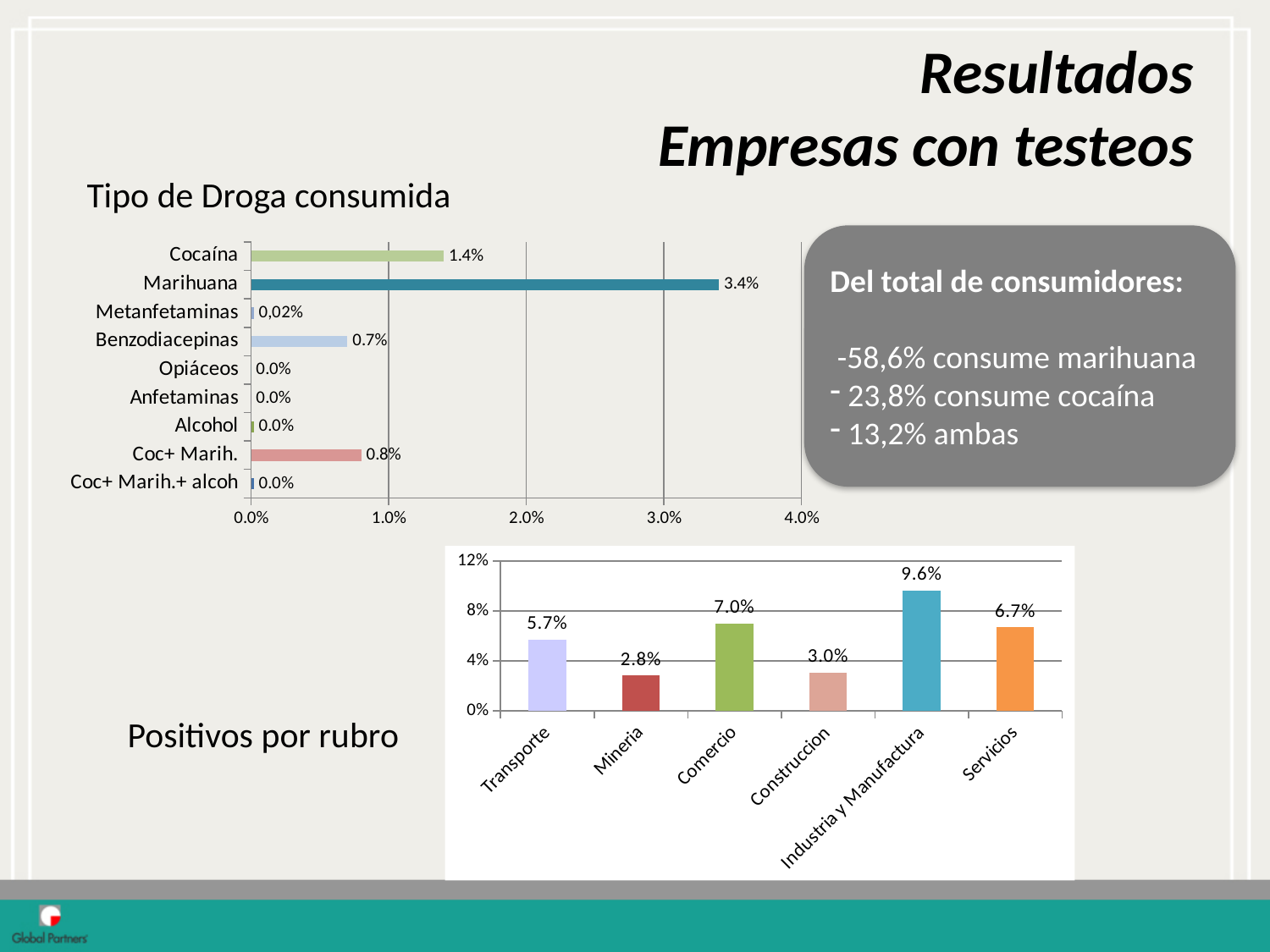
In the 'Tipo de Droga consumida' chart, how many drug categories are listed? 9 In the 'Tipo de Droga consumida' chart, what is the value for Marihuana? 3.4% What type of chart is 'Positivos por rubro'? Bar chart In the 'Positivos por rubro' chart, how many sectors are shown? 6 In the 'Positivos por rubro' chart, what is the difference between Industria y Manufactura and Transporte? 3.9% In the 'Tipo de Droga consumida' chart, what is the value for Coc+ Marih.? 0.8% In the 'Tipo de Droga consumida' chart, what is the value for Cocaína? 1.4% In the 'Positivos por rubro' chart, what is the value for Industria y Manufactura? 9.6% In the 'Positivos por rubro' chart, which sector has the lowest value? Mineria In the 'Tipo de Droga consumida' chart, what is the difference between the values for Marihuana and Cocaína? 2.0% In the 'Tipo de Droga consumida' chart, which drug has the highest value? Marihuana In the 'Positivos por rubro' chart, which is larger, Comercio or Servicios? Comercio